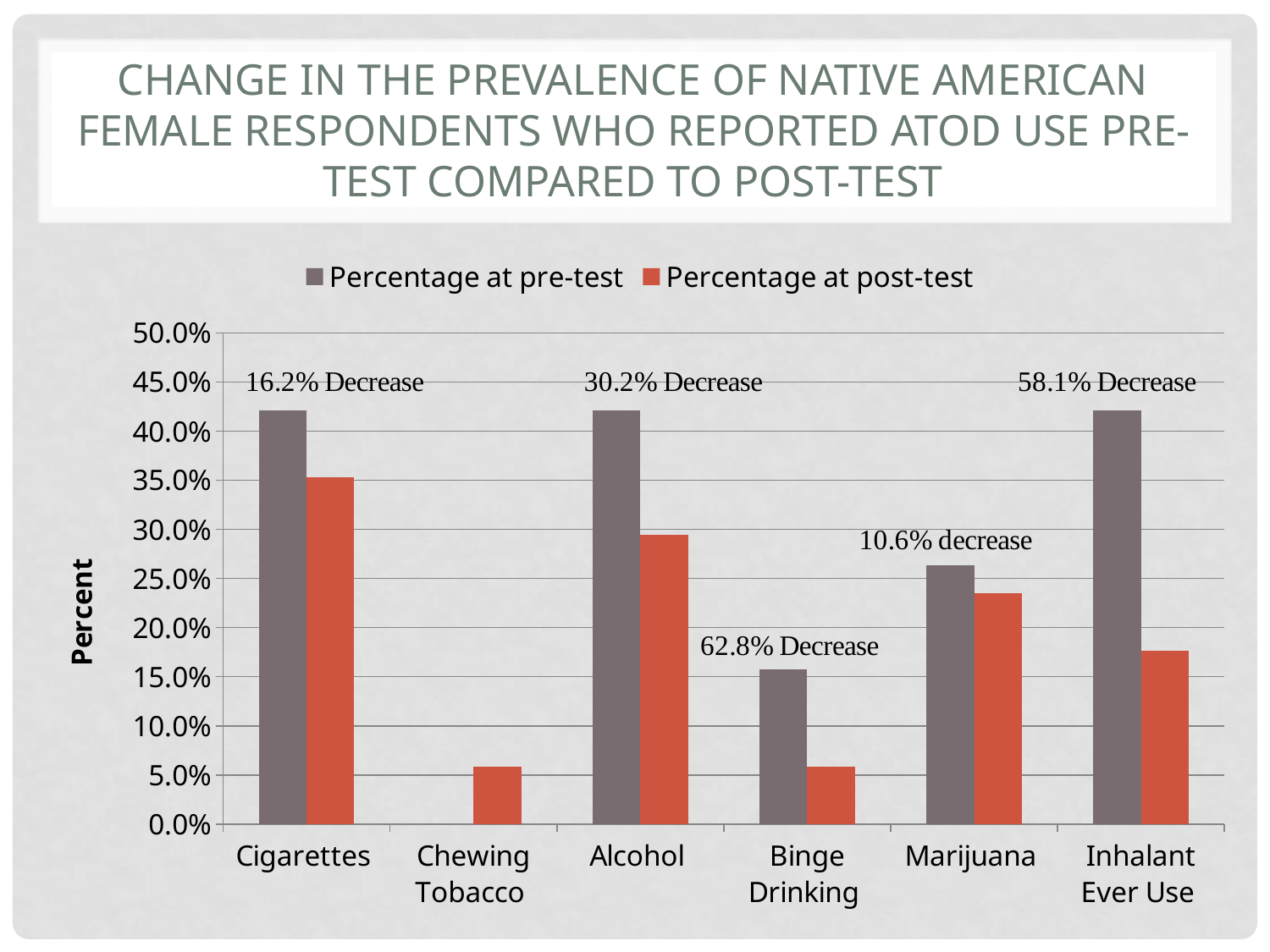
What is the label on the vertical axis? Percent What percentage decrease is annotated above the Binge Drinking bars? 62.8% Decrease Is the post-test value for Binge Drinking greater or less than 10.0%? less Which category has the lowest post-test percentage? Chewing Tobacco and Binge Drinking (tied) Which is larger for Alcohol, the percentage at pre-test or the percentage at post-test? Percentage at pre-test Which category has the lowest pre-test percentage? Chewing Tobacco Is the pre-test value for Cigarettes greater or less than 40.0%? greater Is the pre-test value for Marijuana greater or less than 25.0%? greater What kind of chart is shown on the slide? bar chart How many series does the legend list? 2 How many substance categories are shown on the x axis? 6